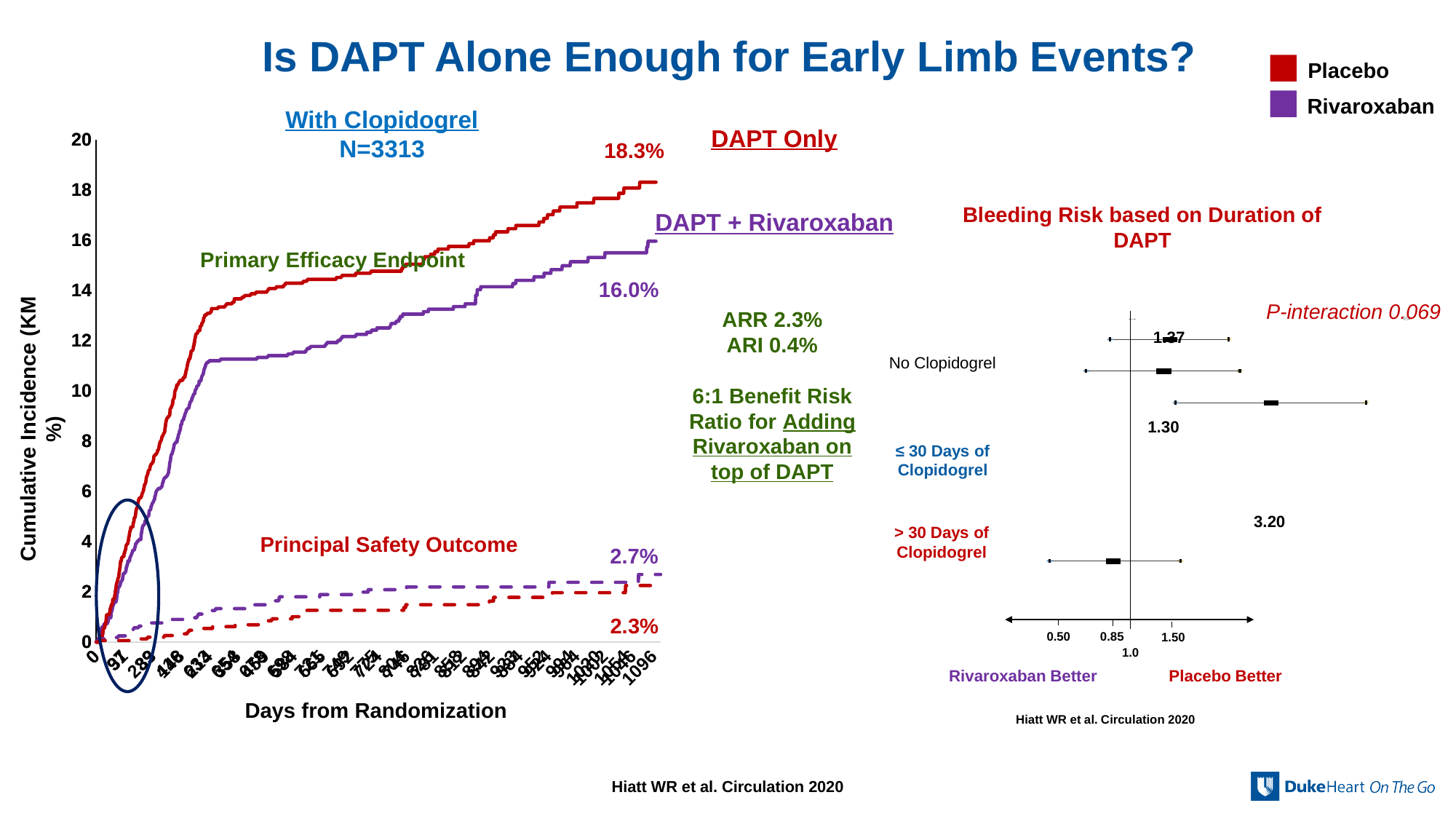
What is the title of the forest plot on the right side of the slide? Bleeding Risk based on Duration of DAPT What P-interaction value is printed on the forest plot on the right? 0.069 On the left chart, what is the final cumulative incidence for the Placebo (DAPT Only) primary efficacy endpoint? 18.3% On the left chart, do the primary efficacy endpoint curves rise or fall as days from randomization increase? Rise On the left chart, what is the final cumulative incidence for the Placebo principal safety outcome? 2.3% What type of chart is the left chart showing cumulative incidence over days from randomization? Line chart On the left chart, what is the final cumulative incidence for the Rivaroxaban (DAPT + Rivaroxaban) primary efficacy endpoint? 16.0% On the left chart, what is the final cumulative incidence for the Rivaroxaban principal safety outcome? 2.7% On the left chart, what is the difference between the Placebo and Rivaroxaban final primary efficacy endpoint values? 2.3% On the left chart, which group has the higher final principal safety outcome incidence, Placebo or Rivaroxaban? Rivaroxaban On the left chart, which group has the higher final primary efficacy endpoint incidence, Placebo or Rivaroxaban? Placebo How many series does the legend at the top right of the slide list? 2